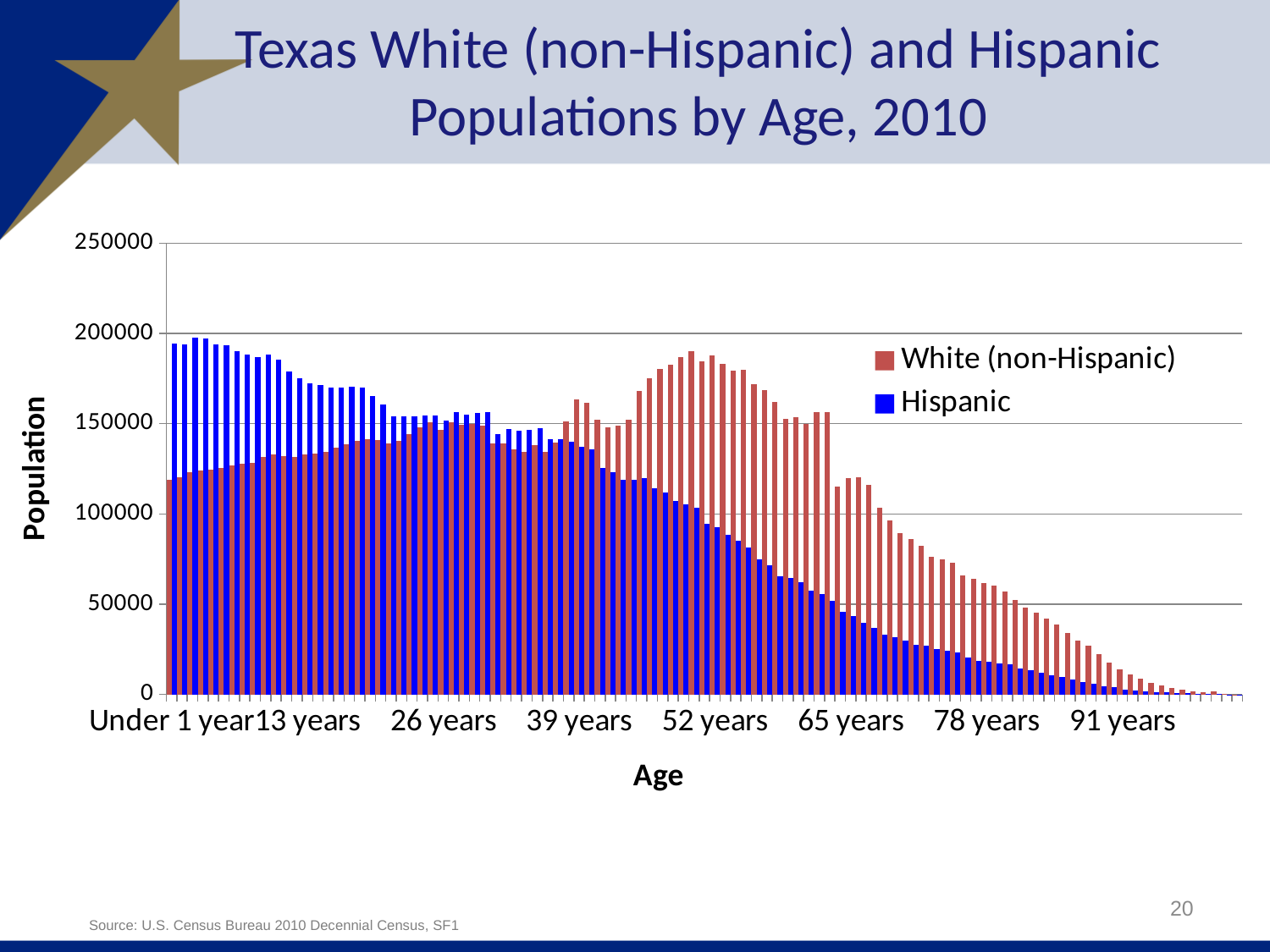
Which colour represents the Hispanic series in the chart? Blue How many series does the legend list? 2 Is the White (non-Hispanic) value for 52 years greater or less than 150000? greater At 52 years, which series has the larger value, White (non-Hispanic) or Hispanic? White (non-Hispanic) Is the Hispanic value for 78 years greater or less than 50000? less Is the Hispanic value for Under 1 year greater or less than 150000? greater What kind of chart is shown on the slide? Bar chart Do the Hispanic values generally rise or fall from 39 years to 91 years? Fall At Under 1 year, which series has the larger value, White (non-Hispanic) or Hispanic? Hispanic What is the title of the chart? Texas White (non-Hispanic) and Hispanic Populations by Age, 2010